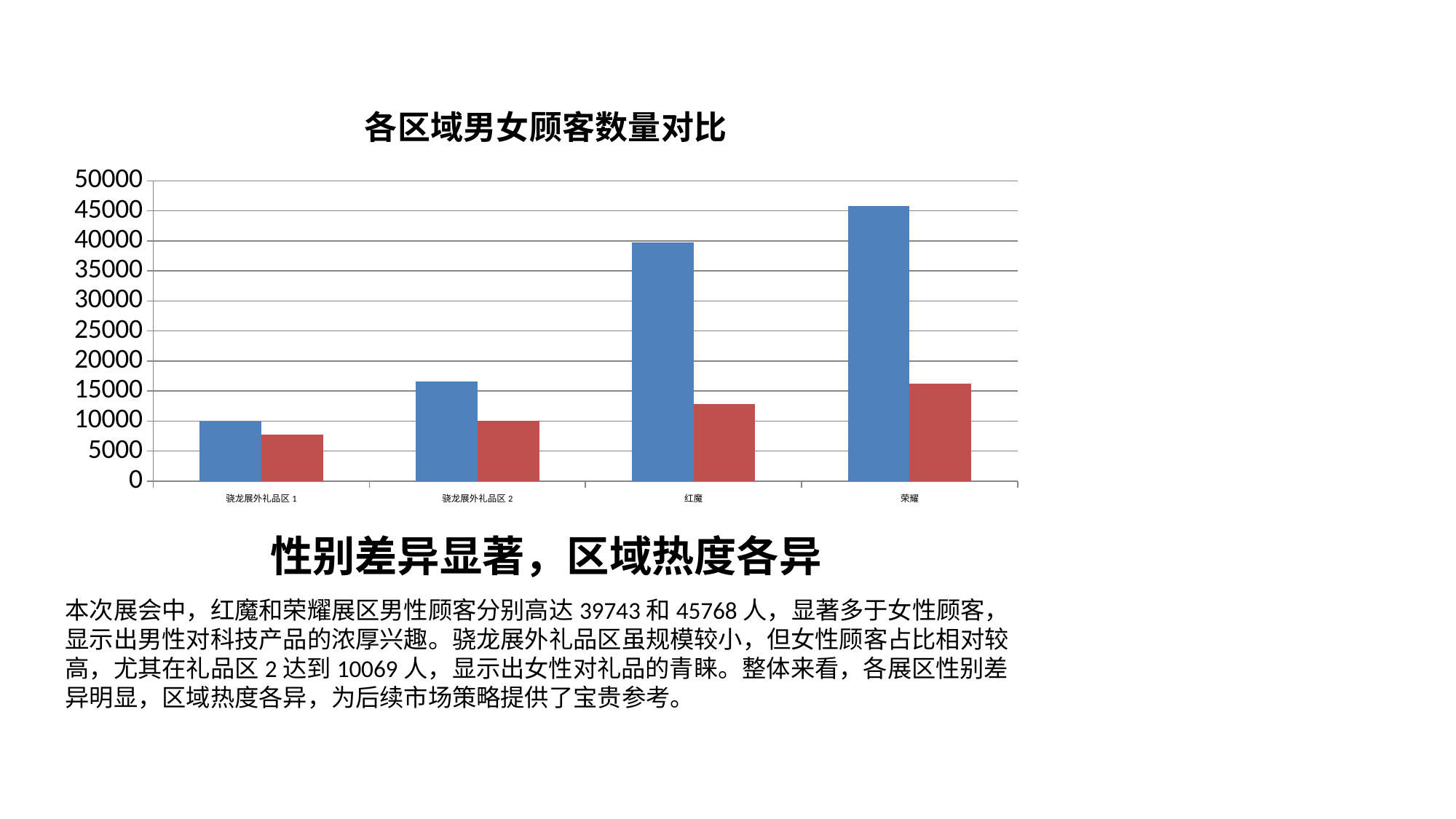
How many categories are shown on the x axis of the chart? 4 What is the title of the chart? 各区域男女顾客数量对比 Which category has the shortest red bar? 骁龙展外礼品区 1 Is the blue bar for 骁龙展外礼品区 1 greater or less than 15000? less Is the red bar for 骁龙展外礼品区 1 greater or less than 10000? less Is the blue bar for 荣耀 greater or less than 40000? greater Do the blue bars rise or fall from left to right across the categories? rise What kind of chart is shown on the slide? bar chart Which category has the tallest blue bar? 荣耀 According to the slide text, how many male customers did the 红魔 area have? 39743 Which is larger, the blue bar for 红魔 or the blue bar for 骁龙展外礼品区 2? 红魔